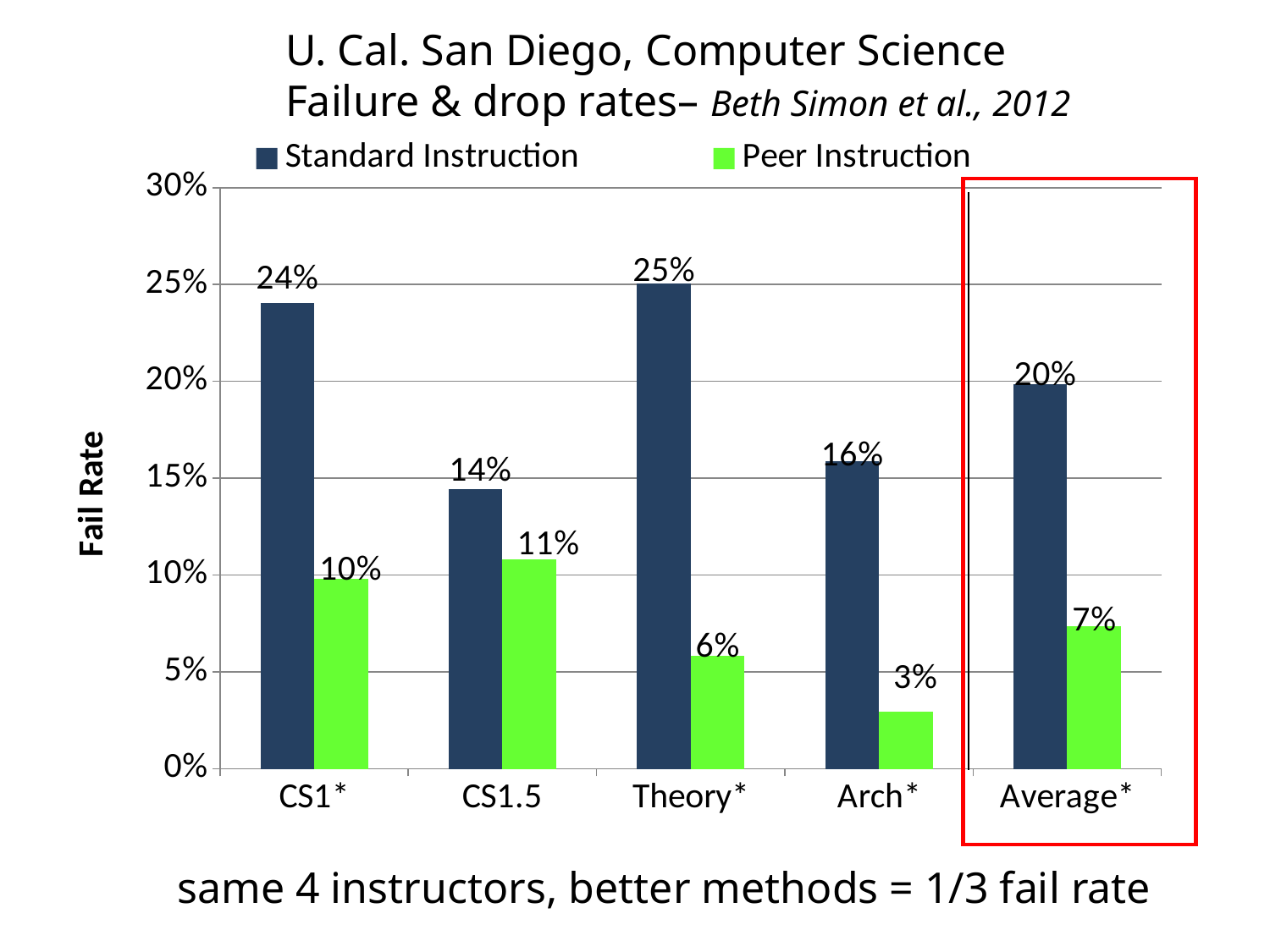
What kind of chart is shown on the slide? bar chart What is the Peer Instruction fail rate for Average*? 7% Which is larger for CS1.5: the Standard Instruction fail rate or the Peer Instruction fail rate? Standard Instruction Which category has the lowest Peer Instruction fail rate? Arch* Is the Standard Instruction fail rate for Arch* greater or less than 20%? less How many series does the legend list? 2 What is the Standard Instruction fail rate for CS1*? 24% What is the label of the y axis? Fail Rate What is the Peer Instruction fail rate for Arch*? 3% Which category has the highest Standard Instruction fail rate? Theory* How many categories are shown on the x axis? 5 What is the difference between the Standard Instruction and Peer Instruction fail rates for Theory*? 19%